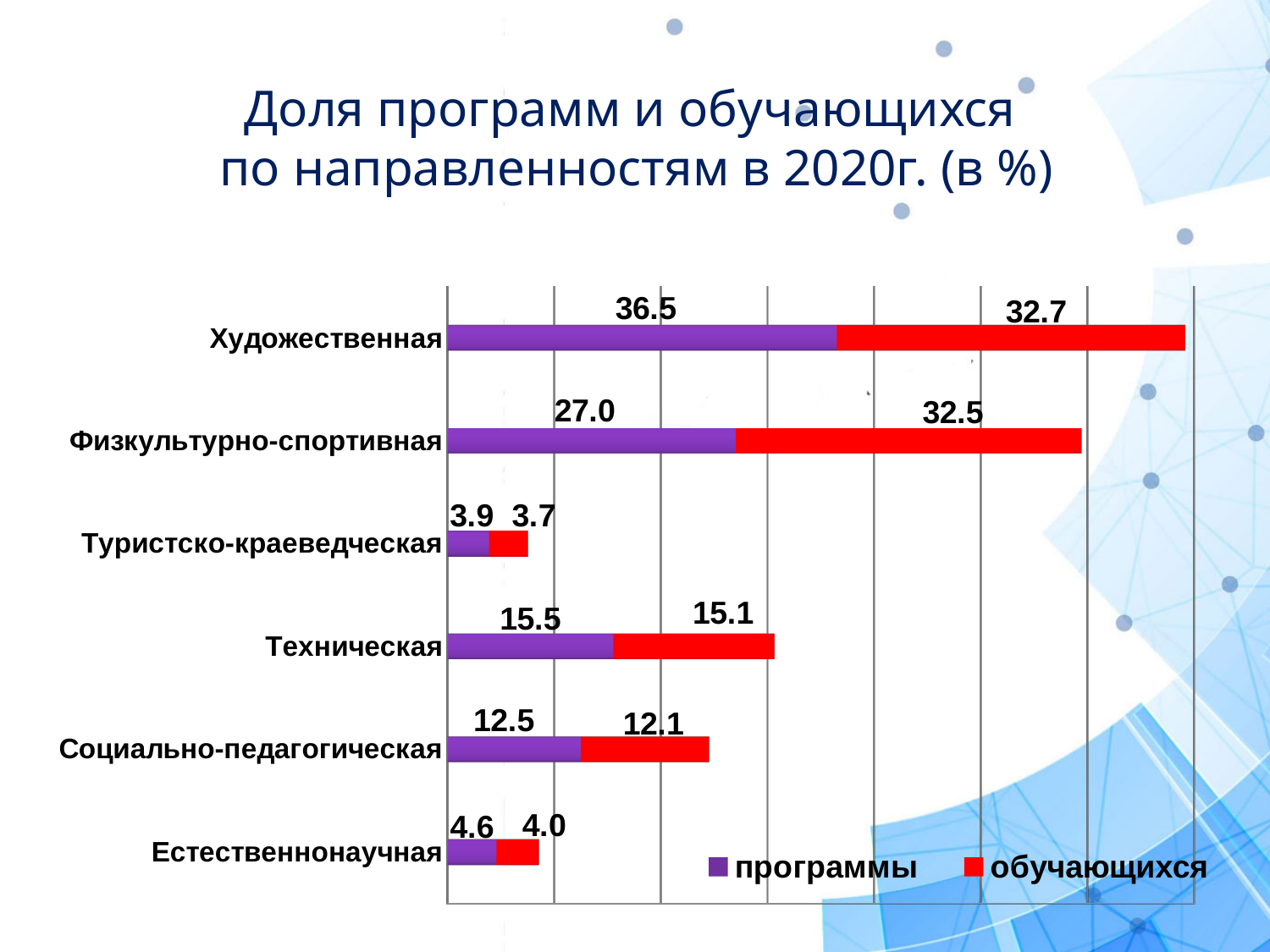
What is the difference between the программы values for Художественная and Физкультурно-спортивная? 9.5 What is the total of the stacked bar for Техническая? 30.6 What is the value of обучающихся for Физкультурно-спортивная? 32.5 How many categories are shown on the chart? 6 Which category has the lowest value for обучающихся? Туристско-краеведческая What kind of chart is shown on the slide? stacked bar chart How many series does the legend list? 2 What is the value of обучающихся for Естественнонаучная? 4.0 Which is larger for Социально-педагогическая: программы or обучающихся? программы What is the value of программы for Техническая? 15.5 What is the value of программы for Художественная? 36.5 Which category has the highest value for программы? Художественная